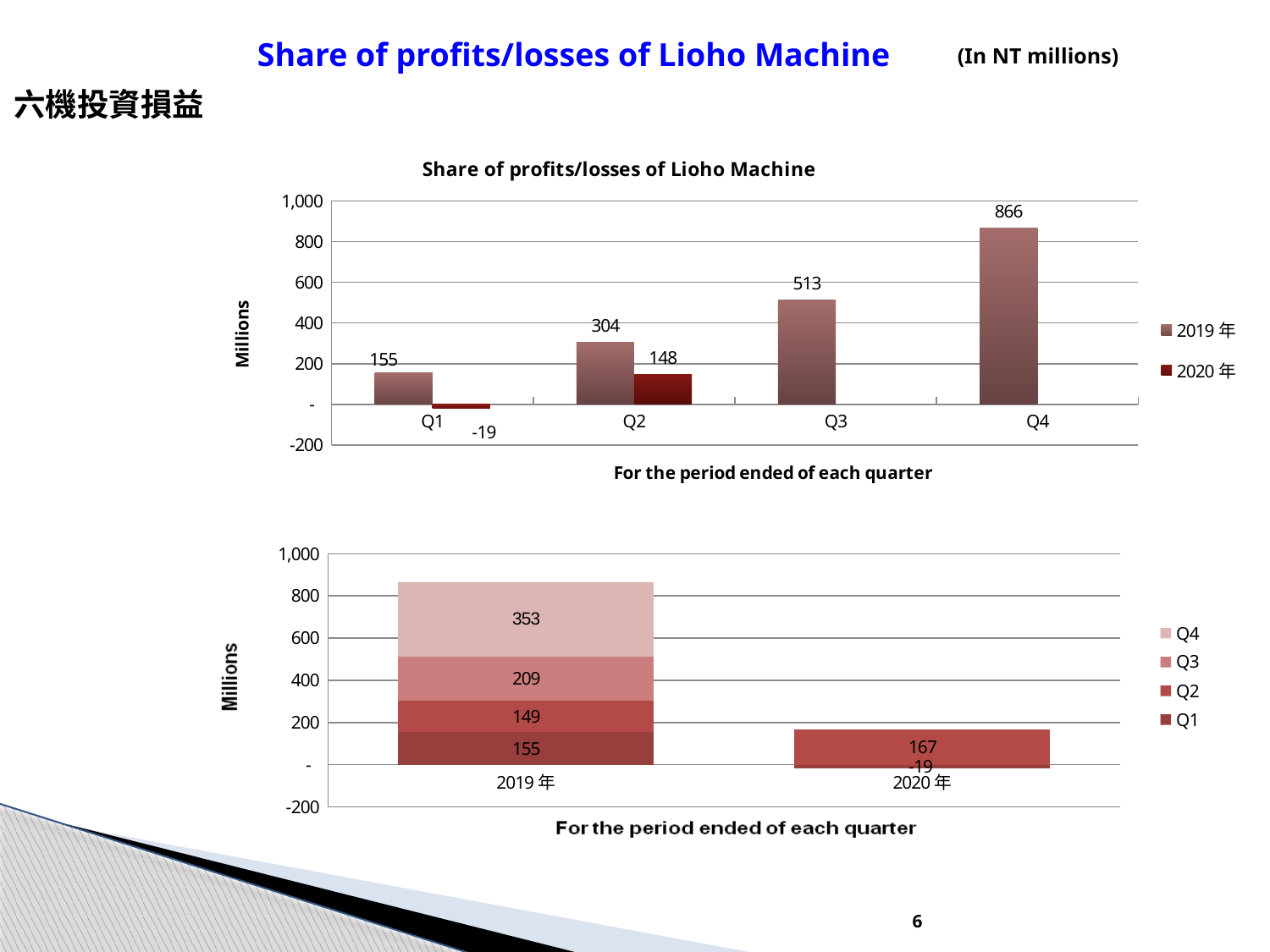
In the top chart, do the 2019 values rise or fall from Q1 to Q4? rise In the bottom chart, what is the Q3 value for 2019 年? 209 What kind of chart is the bottom chart? stacked bar chart In the top chart, what is the 2019 value for Q4? 866 In the top chart, what is the 2020 value for Q2? 148 In the top chart, what is the 2020 value for Q1? -19 In the top chart, how many series does the legend list? 2 In the bottom chart, what is the Q2 value for 2020 年? 167 In the top chart, what is the difference between the 2019 values for Q3 and Q2? 209 In the top chart, which quarter has the highest 2019 value? Q4 In the top chart, which is larger for Q2: the 2019 value or the 2020 value? 2019 In the bottom chart, what is the total of the stacked bar for 2019 年? 866